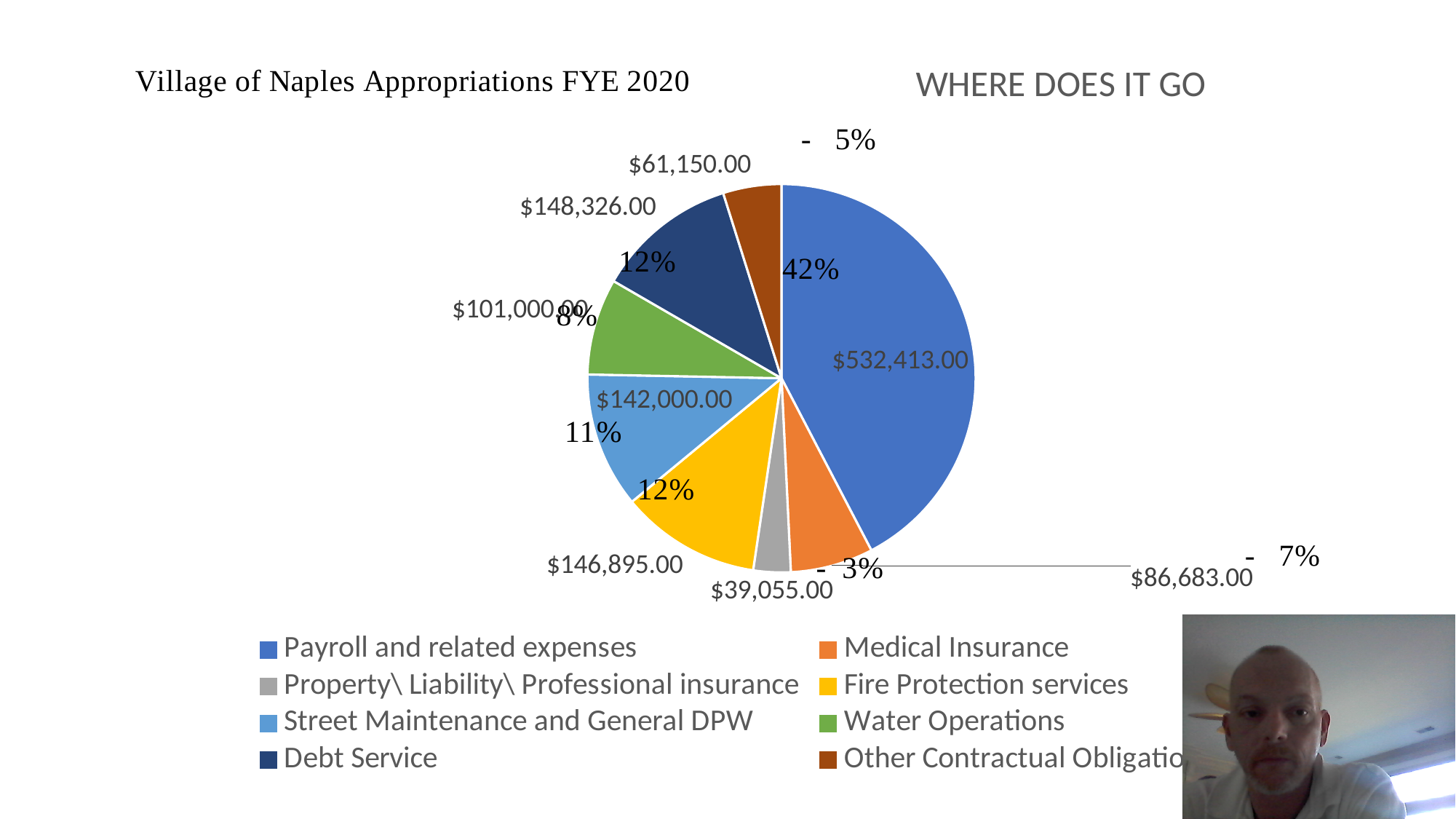
Which category has the smallest slice of the pie? Property\ Liability\ Professional insurance What is the value for Street Maintenance and General DPW? $142,000.00 Which category has the largest slice of the pie? Payroll and related expenses What is the value for Payroll and related expenses? $532,413.00 What is the title of the chart? WHERE DOES IT GO What is the value for Debt Service? $148,326.00 What percentage share of the pie does Payroll and related expenses have? 42% What is the difference between the value for Debt Service and the value for Street Maintenance and General DPW? $6,326.00 What type of chart is shown on the slide? pie chart Which is larger, the value for Medical Insurance or the value for Water Operations? Water Operations What is the value for Fire Protection services? $146,895.00 How many categories does the legend list? 8